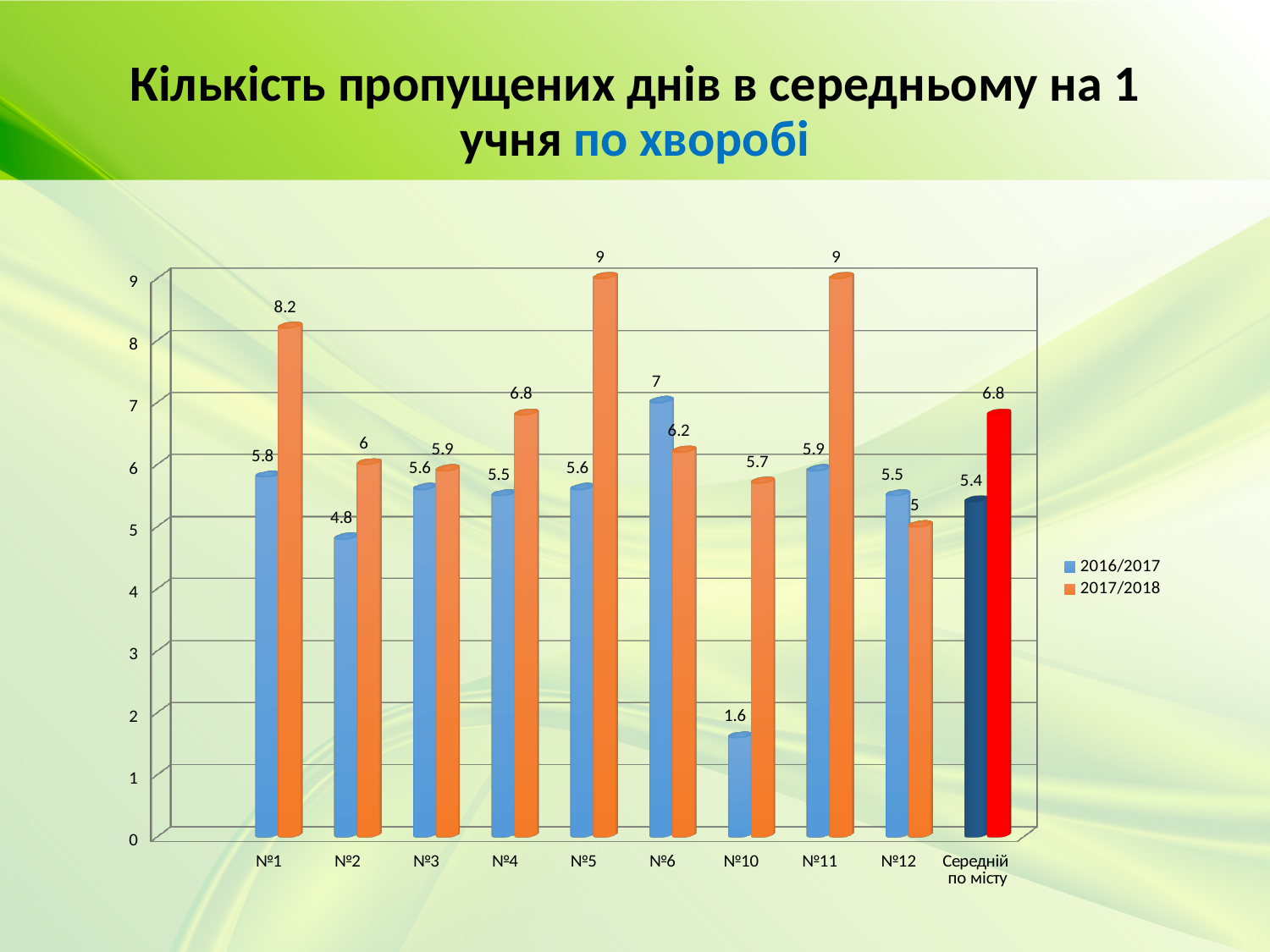
What are the two series names listed in the legend? 2016/2017 and 2017/2018 How many categories are shown on the x axis? 10 Which category has the lowest value in the 2017/2018 series? №12 What is the value for №1 in the 2017/2018 series? 8.2 What is the value for №10 in the 2016/2017 series? 1.6 Which is larger for №6: the 2016/2017 value or the 2017/2018 value? 2016/2017 How many series does the legend list? 2 What kind of chart is shown on the slide? bar chart What is the 2017/2018 value for Середній по місту? 6.8 Which category has the highest value in the 2016/2017 series? №6 What is the difference between the 2017/2018 and 2016/2017 values for №10? 4.1 Which category has the lowest value in the 2016/2017 series? №10